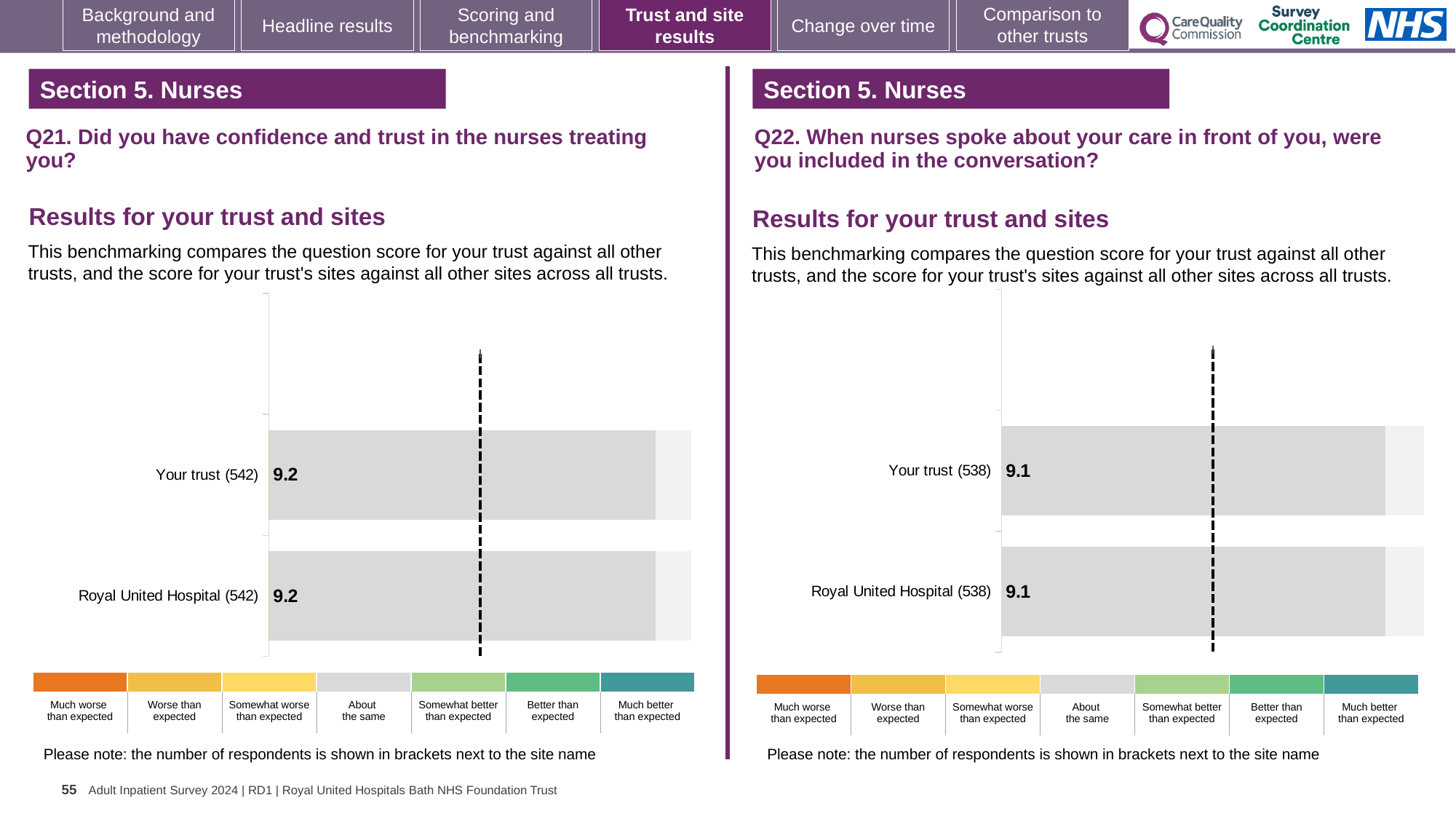
On the Q22 chart (right), what is the score for Royal United Hospital? 9.1 What kind of chart is the Q21 chart on the left? Bar chart On the Q22 chart (right), how many bars are plotted? 2 On the Q22 chart (right), what is the score for Your trust? 9.1 On the Q21 chart (left), how many respondents are shown in brackets for Your trust? 542 On the Q21 chart (left), what is the score for Royal United Hospital? 9.2 On the Q21 chart (left), how many bars are plotted? 2 On the Q21 chart (left), what is the difference between the score for Your trust and the score for Royal United Hospital? 0.0 On the Q21 chart (left), which category does the bar for Your trust fall into according to the colour key? About the same On the Q22 chart (right), what is the difference between the score for Your trust and the score for Royal United Hospital? 0.0 On the Q22 chart (right), how many respondents are shown in brackets for Royal United Hospital? 538 On the Q21 chart (left), what is the score for Your trust? 9.2